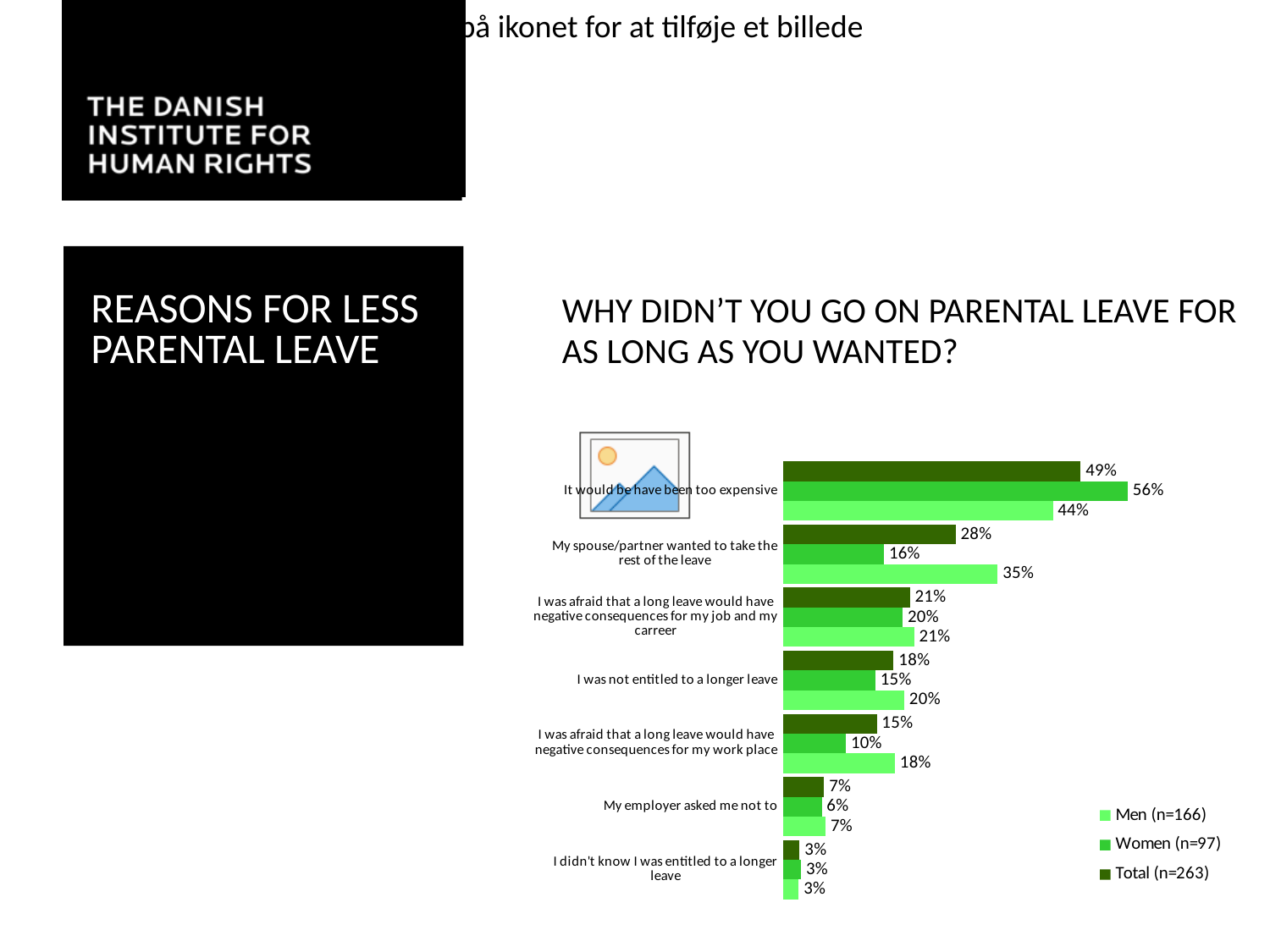
What is the sample size for the Total series shown in the legend? n=263 Which reason has the lowest Total percentage? I didn't know I was entitled to a longer leave What is the Total value for 'My spouse/partner wanted to take the rest of the leave'? 28% How many reasons (categories) are shown in the chart? 7 Which reason has the highest Total percentage? It would be have been too expensive What percentage of women said 'My employer asked me not to'? 6% What percentage of women said it would have been too expensive? 56% What kind of chart is shown on the slide? Bar chart For 'My spouse/partner wanted to take the rest of the leave', which is larger: the Men value or the Women value? Men What is the difference between the Women and Men values for 'It would be have been too expensive'? 12% How many series does the legend list? 3 What percentage of men said 'I was not entitled to a longer leave'? 20%